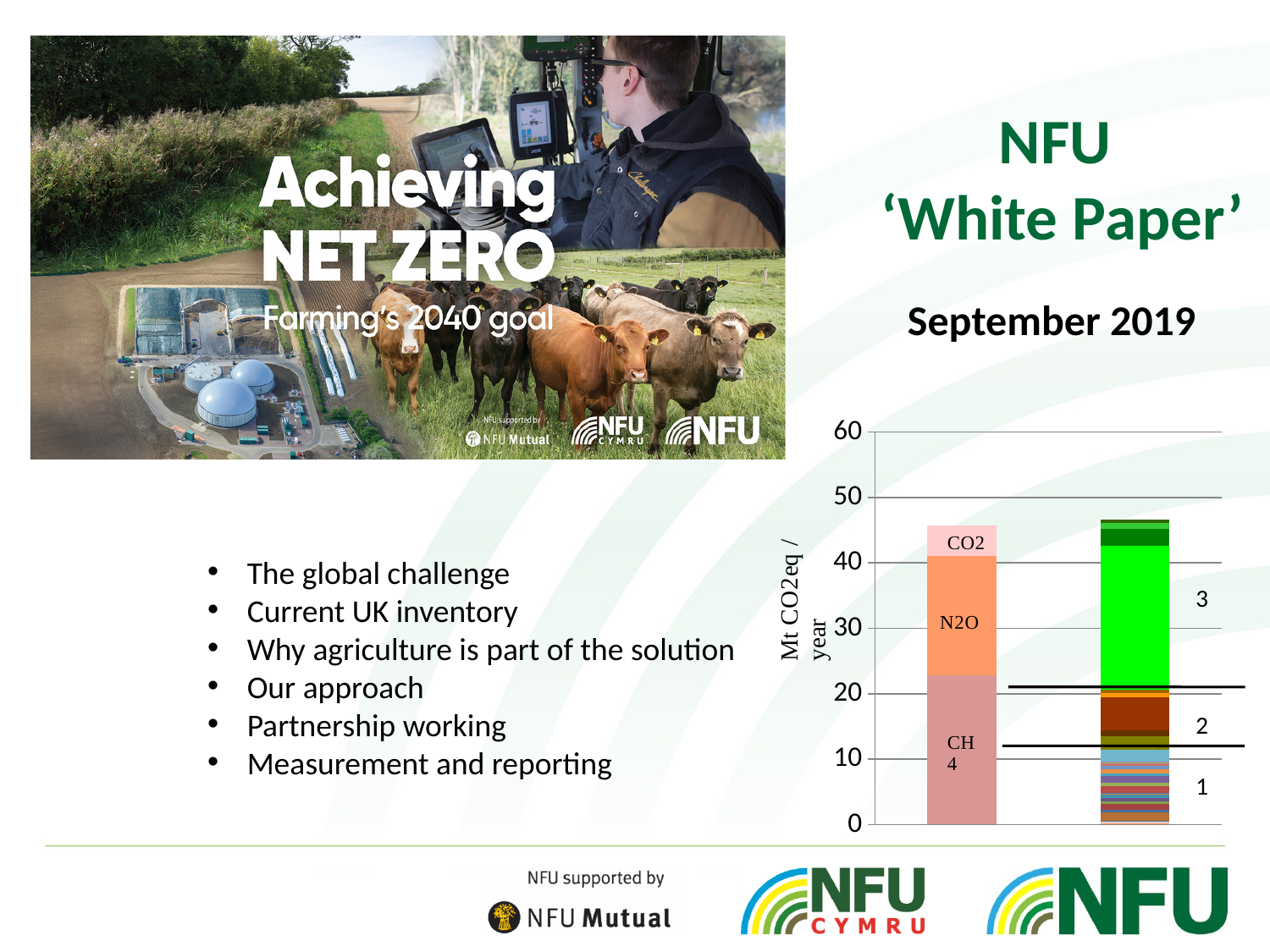
What is the highest value shown on the y-axis? 60 Which segment of the left bar is the smallest? CO2 Is the total height of the left bar greater or less than 50? less How many bars are plotted in the chart? 2 How many labelled segments make up the left bar? 3 Is the top of the CH4 segment in the left bar greater or less than 20? greater Is the total height of the left bar greater or less than 40? greater Which segment of the left bar is the largest? CH4 What is the y-axis label of the chart? Mt CO2eq / year What are the three labelled segments of the left bar? CH4, N2O, CO2 What kind of chart is shown on the slide? Stacked bar chart